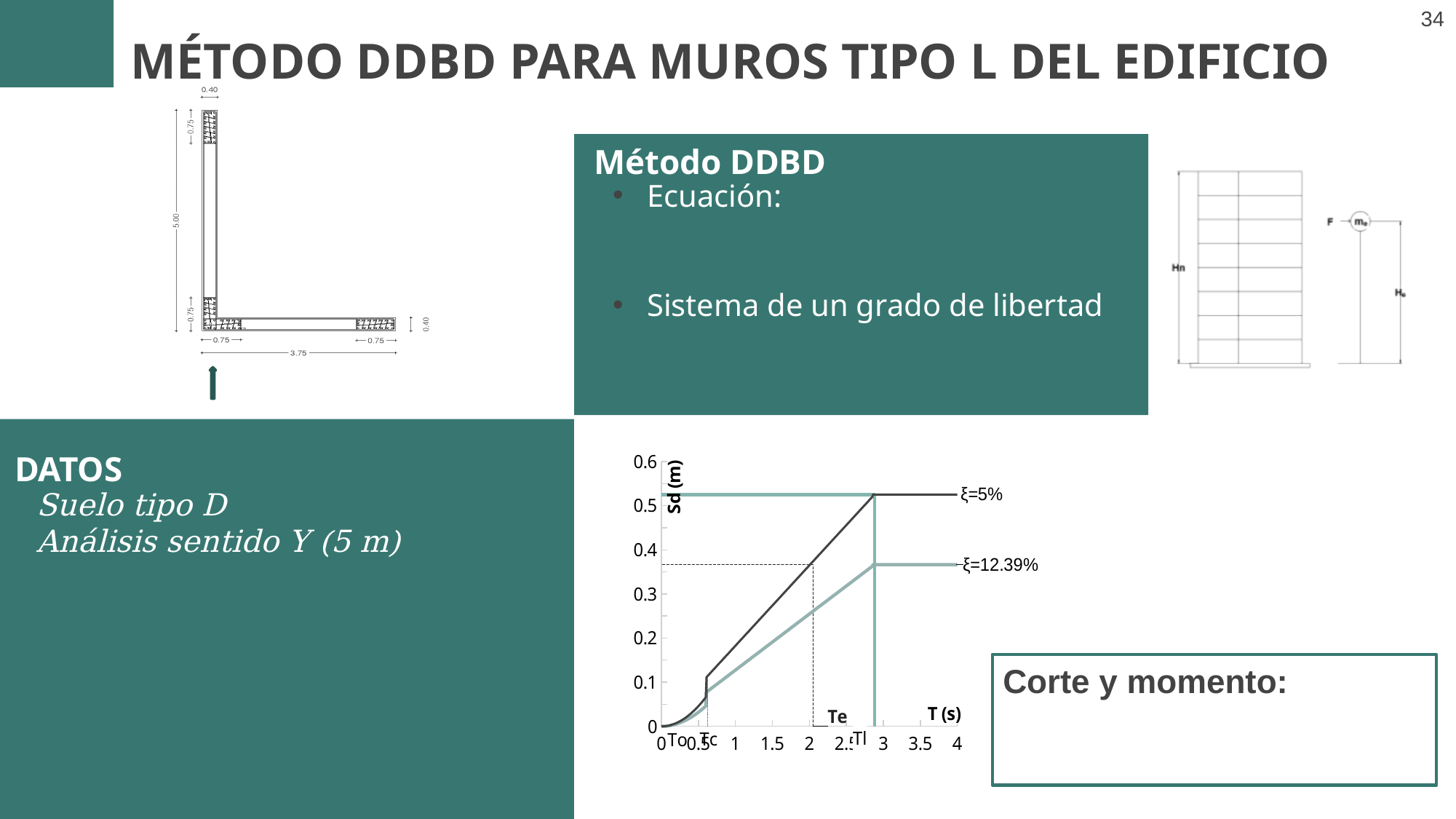
Is the plateau value of the ξ=12.39% series greater or less than 0.3? greater What kind of chart is shown at the bottom of the slide? line chart Is the value of the ξ=5% series at T = 2 s greater or less than 0.3? greater Is the value of the ξ=12.39% series at T = 1 s greater or less than 0.2? less What is the label of the vertical axis of the chart? Sd (m) What are the two damping series labelled in the chart? ξ=5% and ξ=12.39% Which series reaches the higher plateau value, ξ=5% or ξ=12.39%? ξ=5% At T = 2 s, which series has the larger Sd value, ξ=5% or ξ=12.39%? ξ=5% What is the highest tick value shown on the vertical axis? 0.6 Do the Sd values rise or fall as T increases from 0 to about 2.8 s? rise